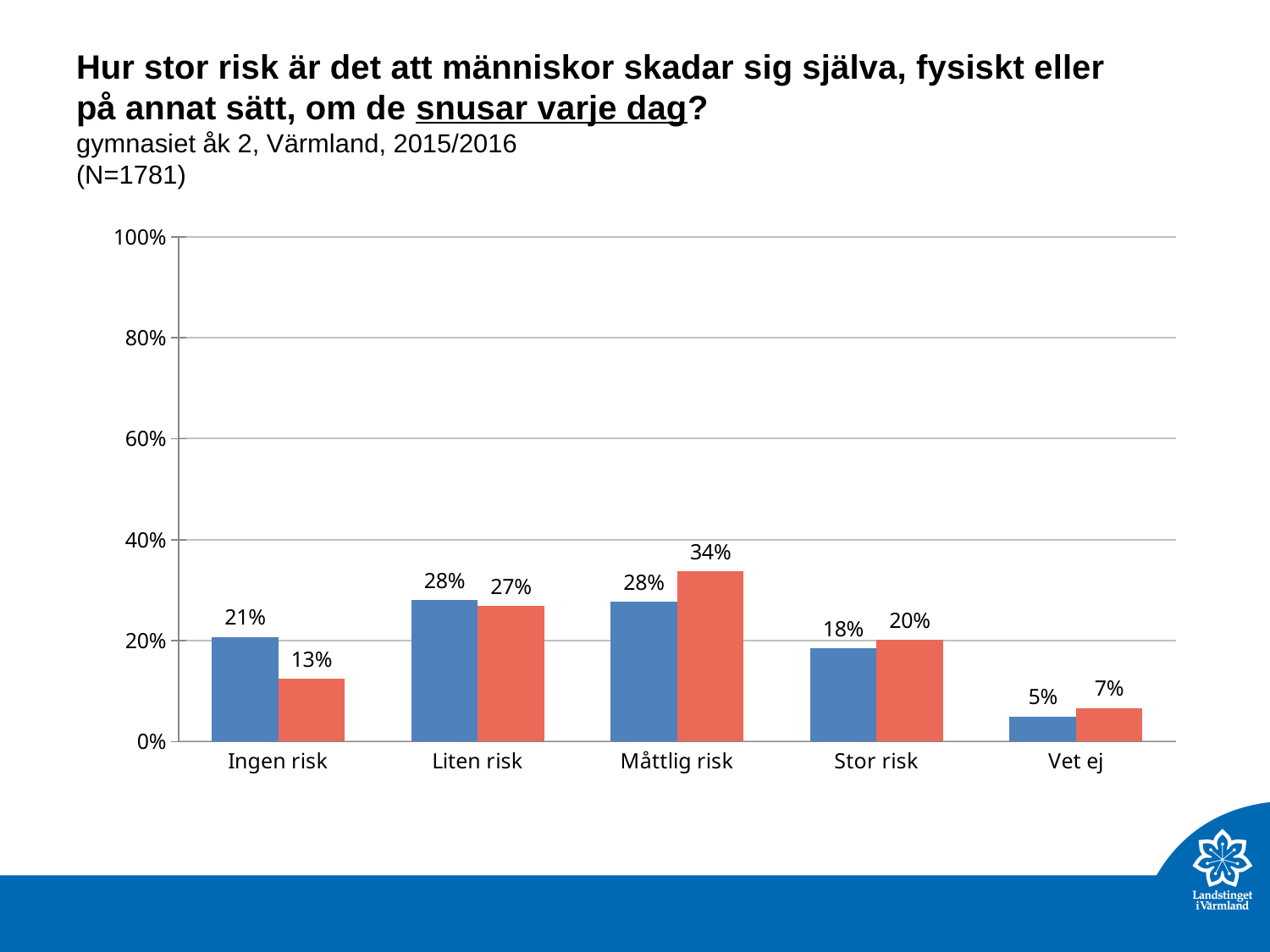
Which category has the lowest value for the blue bars? Vet ej What is the sample size (N) stated on the slide? 1781 What is the value of the blue bar for Ingen risk? 21% How many categories are shown on the x axis? 5 What is the difference between the blue and red bars for Ingen risk? 8 percentage points What is the value of the blue bar for Stor risk? 18% Which category has the highest value for the red bars? Måttlig risk What kind of chart is shown on the slide? bar chart What is the value of the red bar for Vet ej? 7% What is the difference between the red and blue bars for Måttlig risk? 6 percentage points What is the value of the red bar for Måttlig risk? 34% For Stor risk, which bar is larger, the blue or the red? red